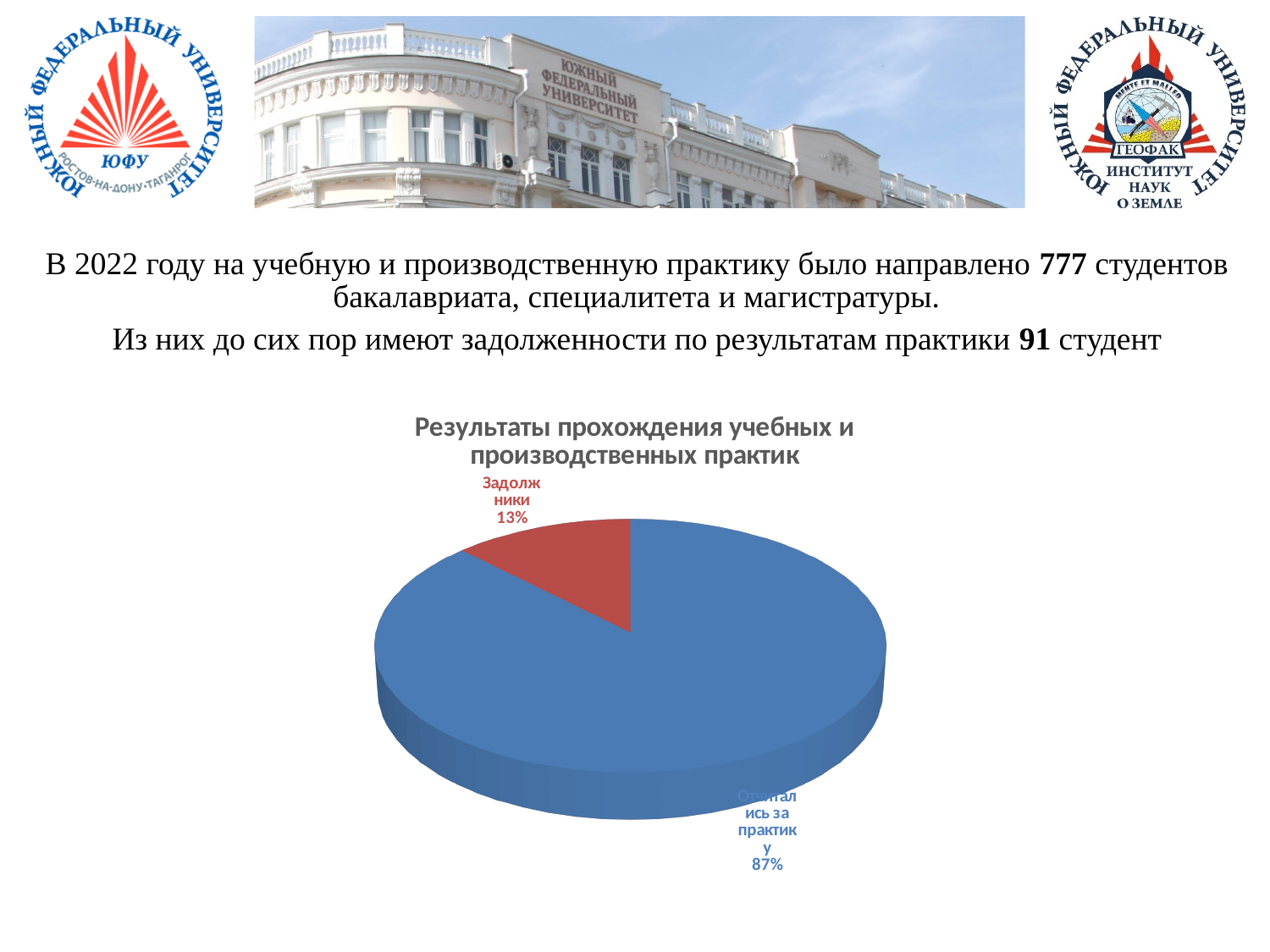
How many slices does the pie chart have? 2 Which slice of the pie chart is the smallest? Задолжники What kind of chart is shown on the slide? pie chart What share of the pie does the slice "Отчитались за практику" represent? 87% What colour is the "Задолжники" slice of the pie chart? red Which slice is larger, "Задолжники" or "Отчитались за практику"? Отчитались за практику Which slice of the pie chart is the largest? Отчитались за практику What is the difference in percentage points between the "Отчитались за практику" slice and the "Задолжники" slice? 74 What is the title of the chart? Результаты прохождения учебных и производственных практик What share of the pie does the slice "Задолжники" represent? 13% Is the share of the "Задолжники" slice greater or less than 50%? less